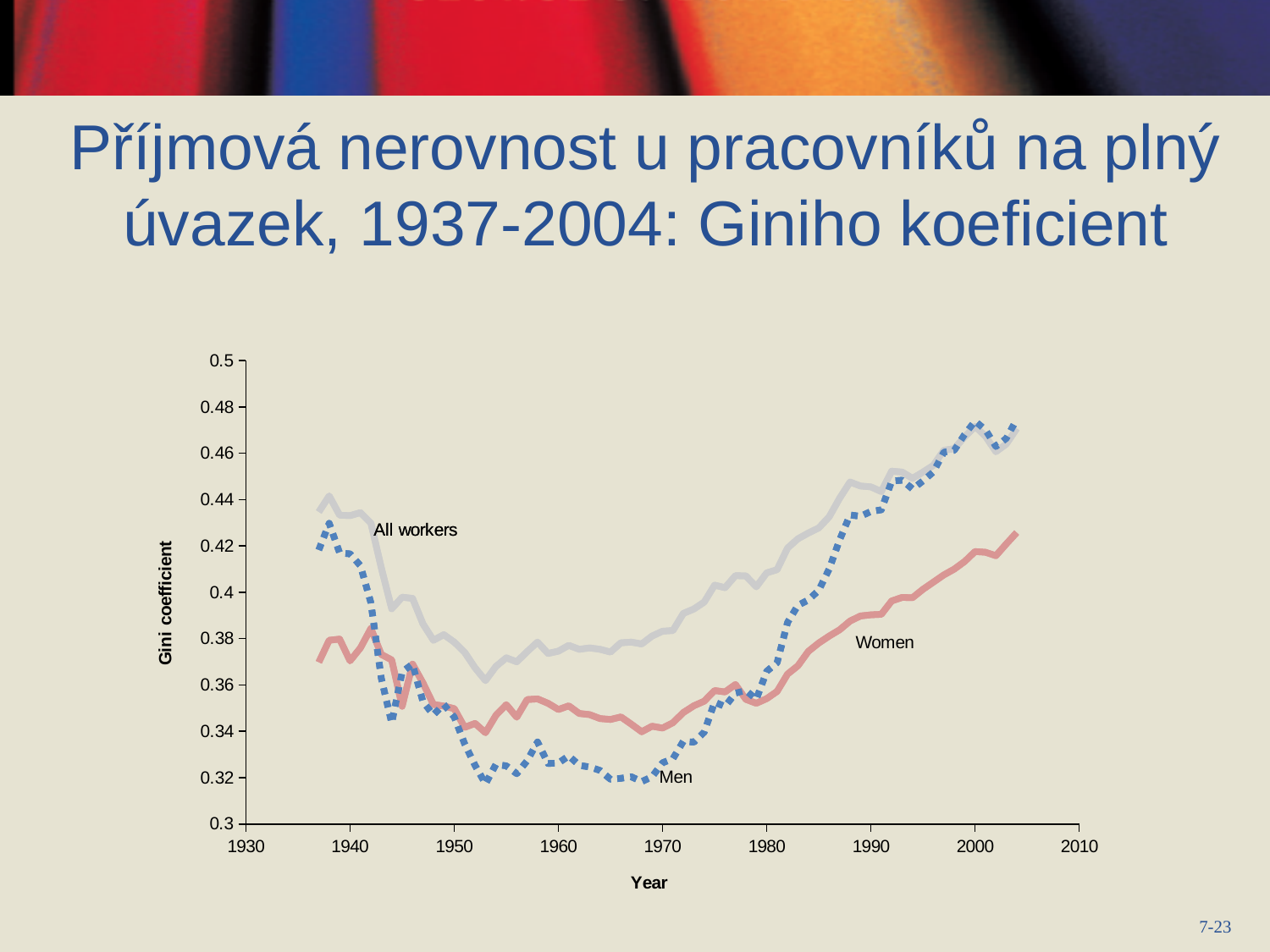
In 1960, which series has the higher value, All workers or Women? All workers What is the label of the vertical axis? Gini coefficient Is the value for All workers in 1953 greater or less than 0.38? less Is the value for Men in 1953 greater or less than 0.34? less Does the Men series rise or fall between 1970 and 2004? rise Is the value for Men in 2000 greater or less than 0.46? greater What kind of chart is shown on the slide? line chart Which series has the lowest value in 2004? Women What is the label of the horizontal axis? Year How many series are plotted on the chart? 3 In 1990, which series has the higher value, Men or Women? Men